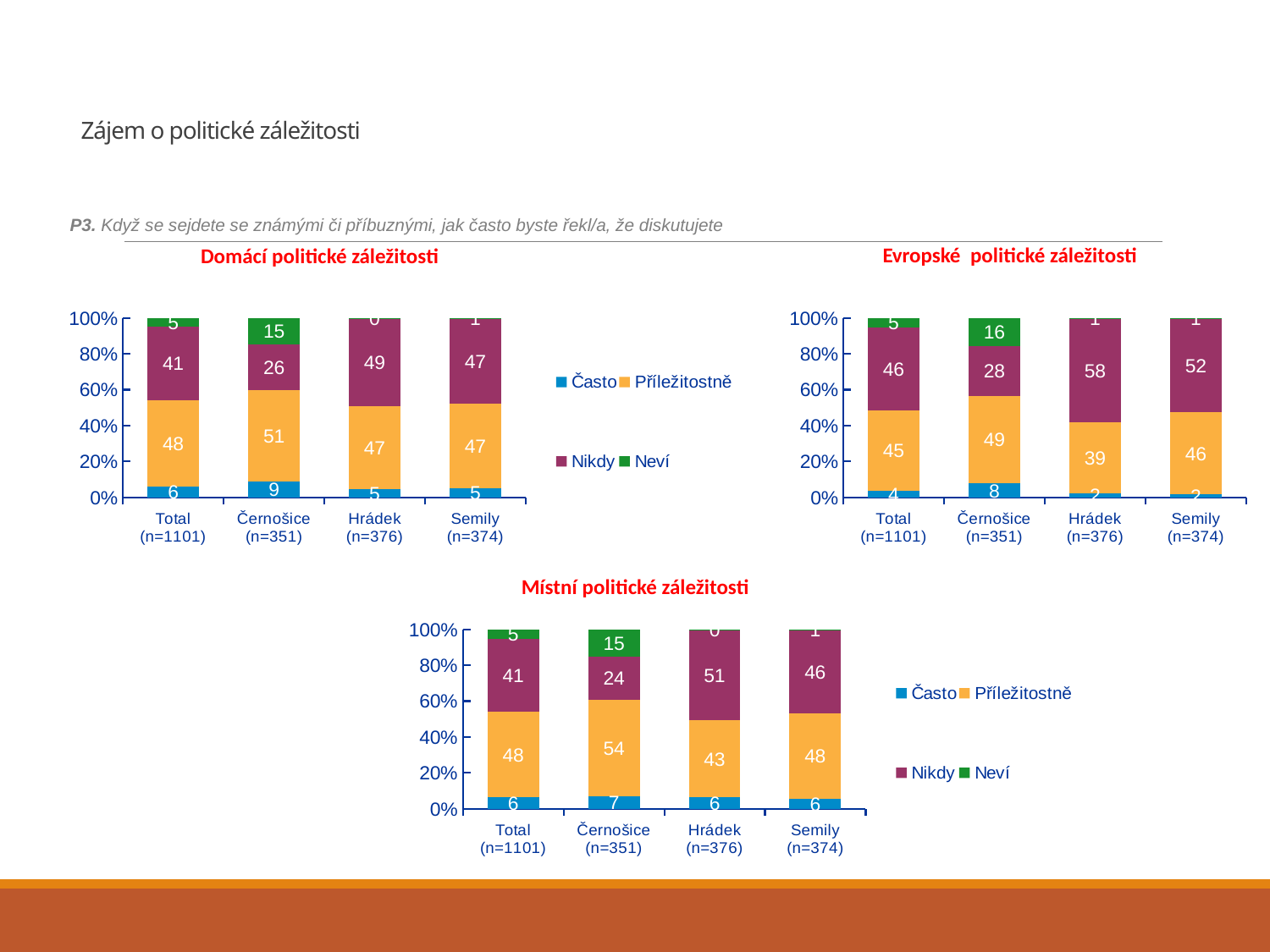
In the 'Místní politické záležitosti' chart, what is the value of Příležitostně for Černošice (n=351)? 54 What kind of chart is the 'Evropské politické záležitosti' chart? Stacked bar chart In the 'Domácí politické záležitosti' chart, what is the value of Příležitostně for Černošice (n=351)? 51 In the 'Místní politické záležitosti' chart, which category has the lowest value for Nikdy? Černošice (n=351) In the 'Evropské politické záležitosti' chart, what is the value of Nikdy for Hrádek (n=376)? 58 In the 'Místní politické záležitosti' chart, what is the difference between the Nikdy values for Hrádek (n=376) and Total (n=1101)? 10 How many series does the legend of the 'Domácí politické záležitosti' chart list? 4 How many categories are shown on the x axis of the 'Místní politické záležitosti' chart? 4 In the 'Evropské politické záležitosti' chart, which category has the highest value for Neví? Černošice (n=351) In the 'Domácí politické záležitosti' chart, what is the value of Často for Černošice (n=351)? 9 In the 'Domácí politické záležitosti' chart, what is the value of Nikdy for Hrádek (n=376)? 49 In the 'Evropské politické záležitosti' chart, is the Příležitostně value larger for Černošice (n=351) or for Hrádek (n=376)? Černošice (n=351)